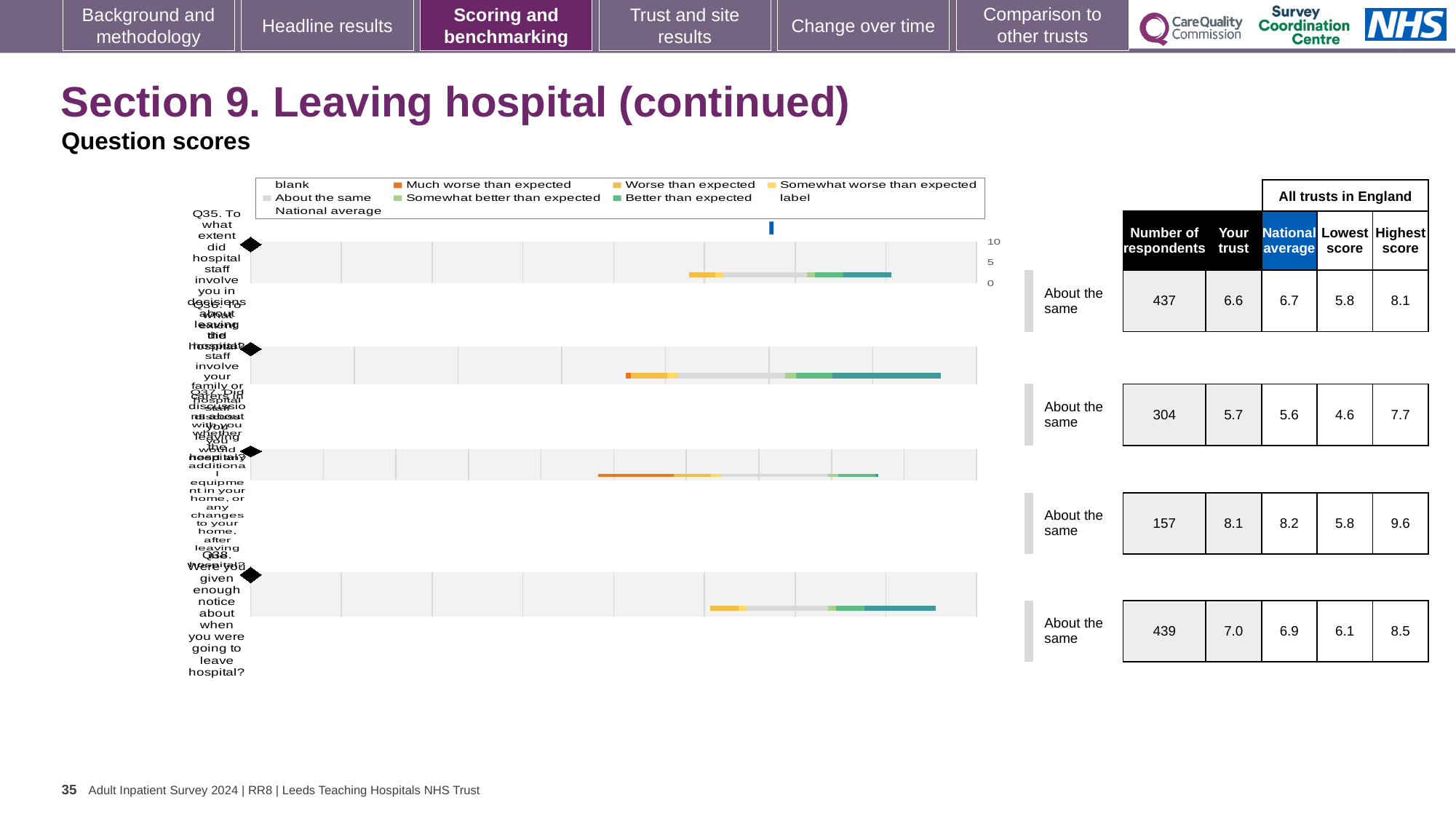
What is the national average for Q38 (given enough notice about when you were going to leave hospital)? 6.9 How many question rows are plotted in the chart? 4 What kind of chart is shown on the slide? bar chart Is the 'Your trust' score for Q38 larger or smaller than the national average for Q38? larger How many entries does the chart legend list? 9 How many respondents answered Q38 (given enough notice about leaving hospital)? 439 What is the lowest score across all trusts in England for the second question row (Q36)? 4.6 What is the 'Your trust' score for Q35 (involving you in decisions about leaving hospital)? 6.6 What is the highest score across all trusts in England for the third question row (Q37)? 9.6 What is the difference between the 'Your trust' score and the national average for Q35? 0.1 Which question row has the fewest respondents? Q37 Which question row has the highest 'Your trust' score? Q37